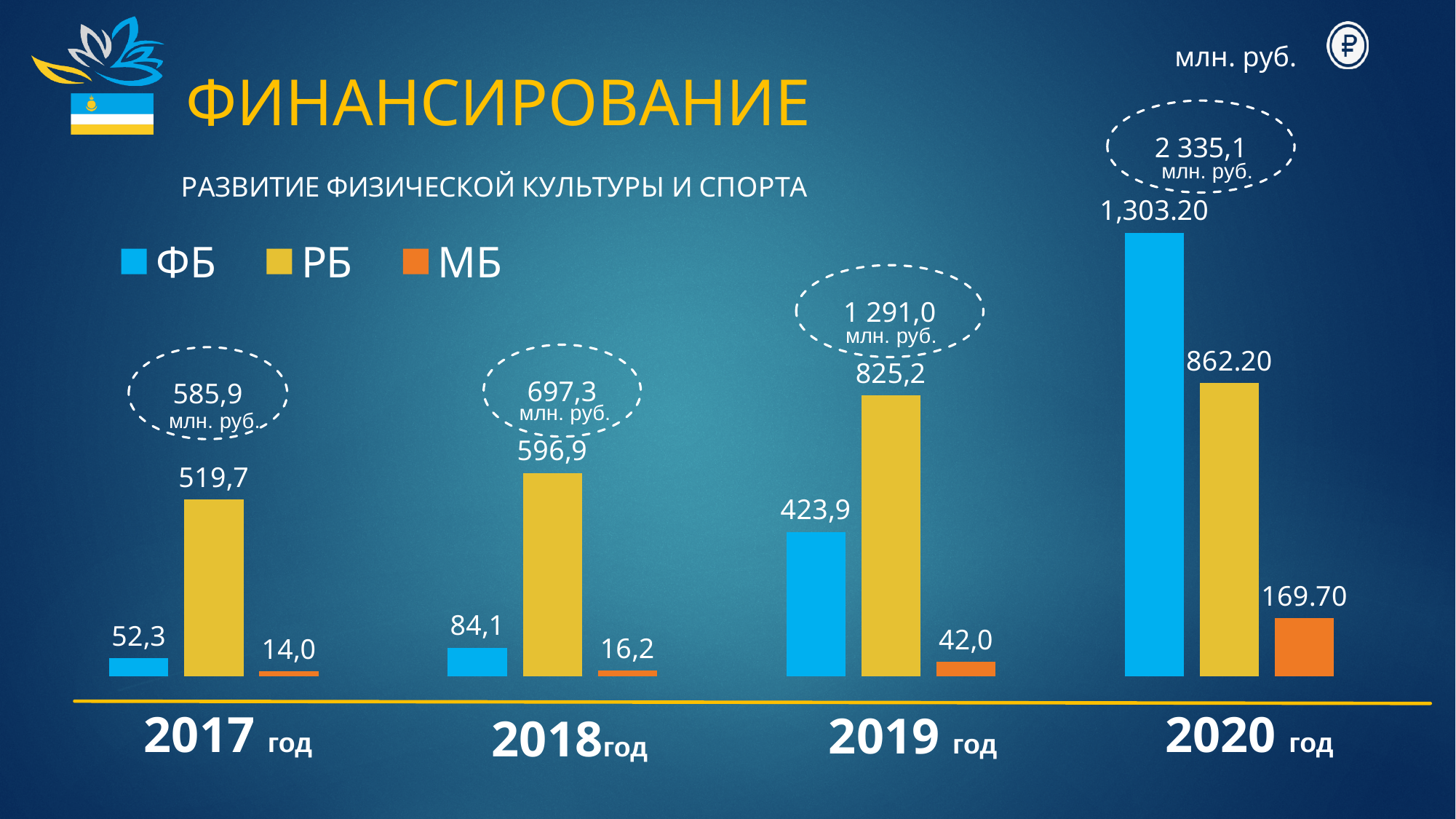
Do the ФБ values rise or fall from 2017 to 2020? rise What total is shown in the dashed oval for 2019? 1 291,0 млн. руб. What is the value for ФБ in 2019? 423,9 In which year is the МБ value lowest? 2017 In which year is the ФБ value highest? 2020 How many series does the legend list? 3 How many years are shown on the x axis? 4 Which is larger in 2020, the ФБ value or the РБ value? ФБ What is the value for РБ in 2017? 519,7 What type of chart is shown on the slide? bar chart What is the difference between the ФБ values for 2019 and 2018? 339,8 What is the value for МБ in 2020? 169.70